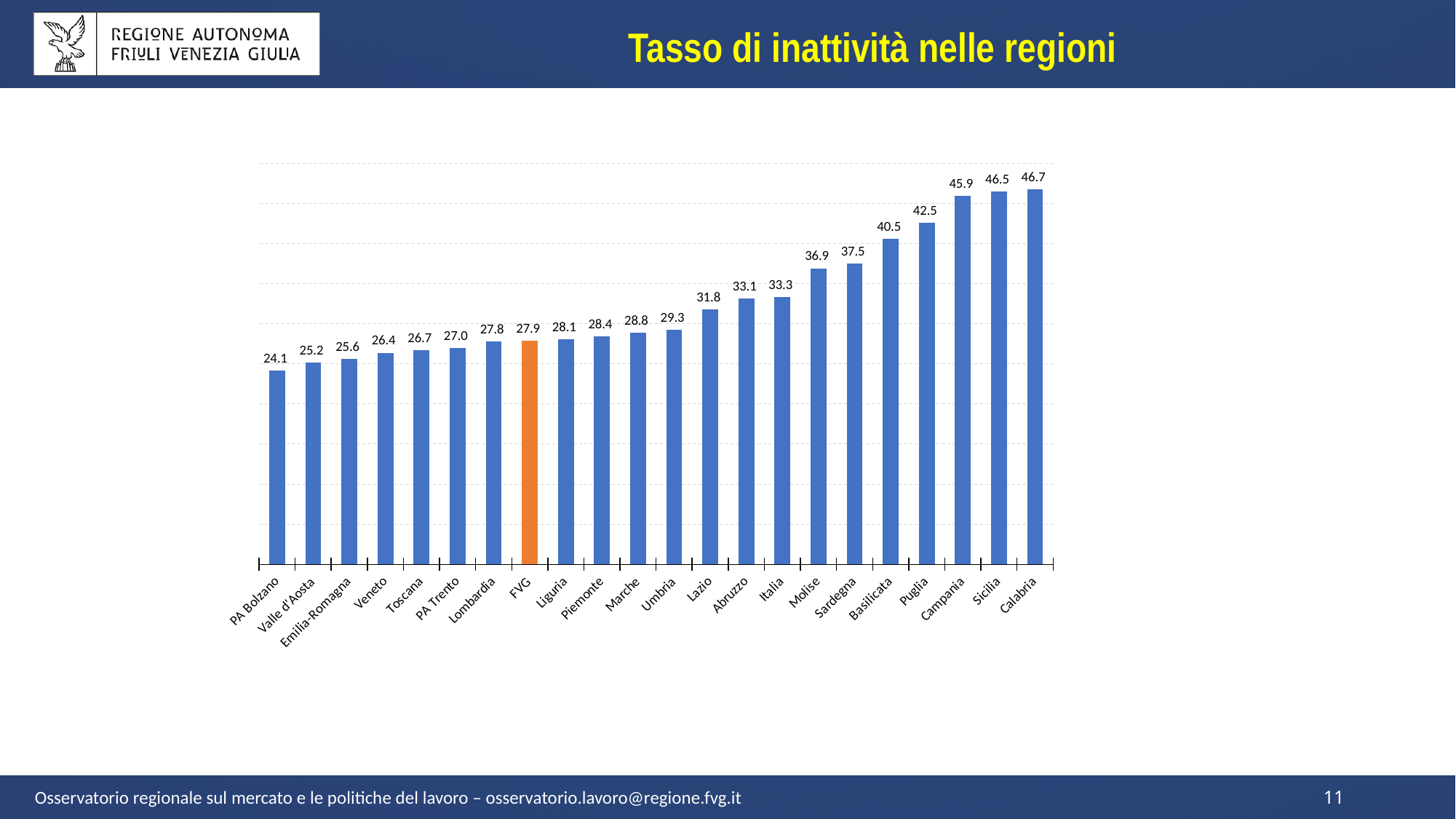
What is the difference between the values for Calabria and PA Bolzano? 22.6 Which region has the highest value? Calabria Which has a larger value, Puglia or Molise? Puglia What is the difference between the values for Italia and FVG? 5.4 What kind of chart is shown on the slide? Bar chart How many bars are shown in the chart? 22 What is the value for Italia? 33.3 Do the values rise or fall from left to right along the x axis? Rise Which region has the lowest value? PA Bolzano Which bar is coloured orange instead of blue? FVG What is the value for Lombardia? 27.8 What is the value for FVG? 27.9